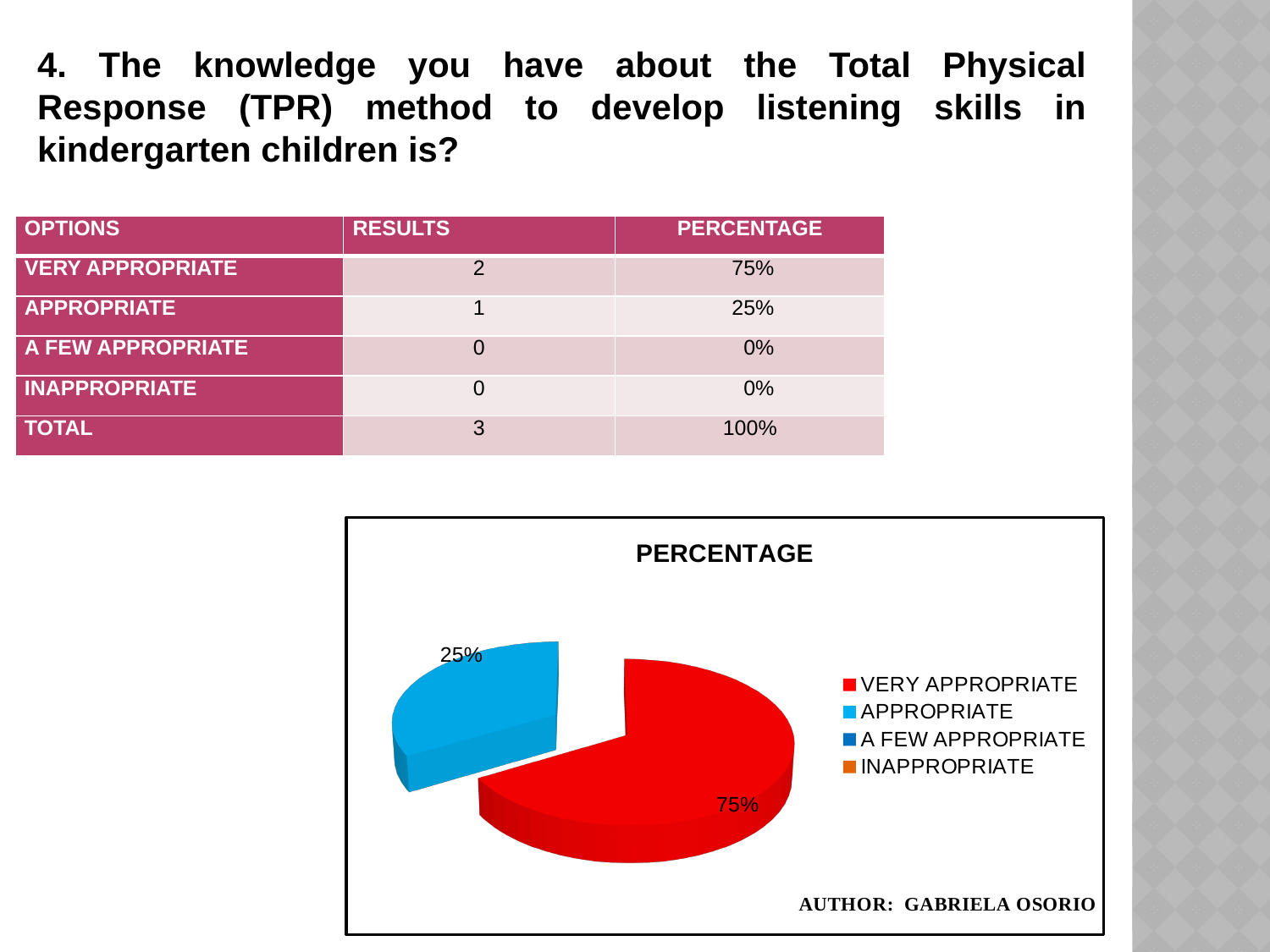
Which is larger, the VERY APPROPRIATE slice or the APPROPRIATE slice? VERY APPROPRIATE Which category has the largest slice of the pie? VERY APPROPRIATE How many entries does the legend list? 4 What kind of chart is shown on the slide? pie chart What share of the pie does the APPROPRIATE slice represent? 25% What is the chart's title? PERCENTAGE What percentage does the VERY APPROPRIATE slice show? 75% How many slices with a visible, non-zero value are shown in the pie? 2 What is the difference between the VERY APPROPRIATE and APPROPRIATE slices? 50% What percentage does the APPROPRIATE slice show? 25% What colour is the VERY APPROPRIATE slice? red